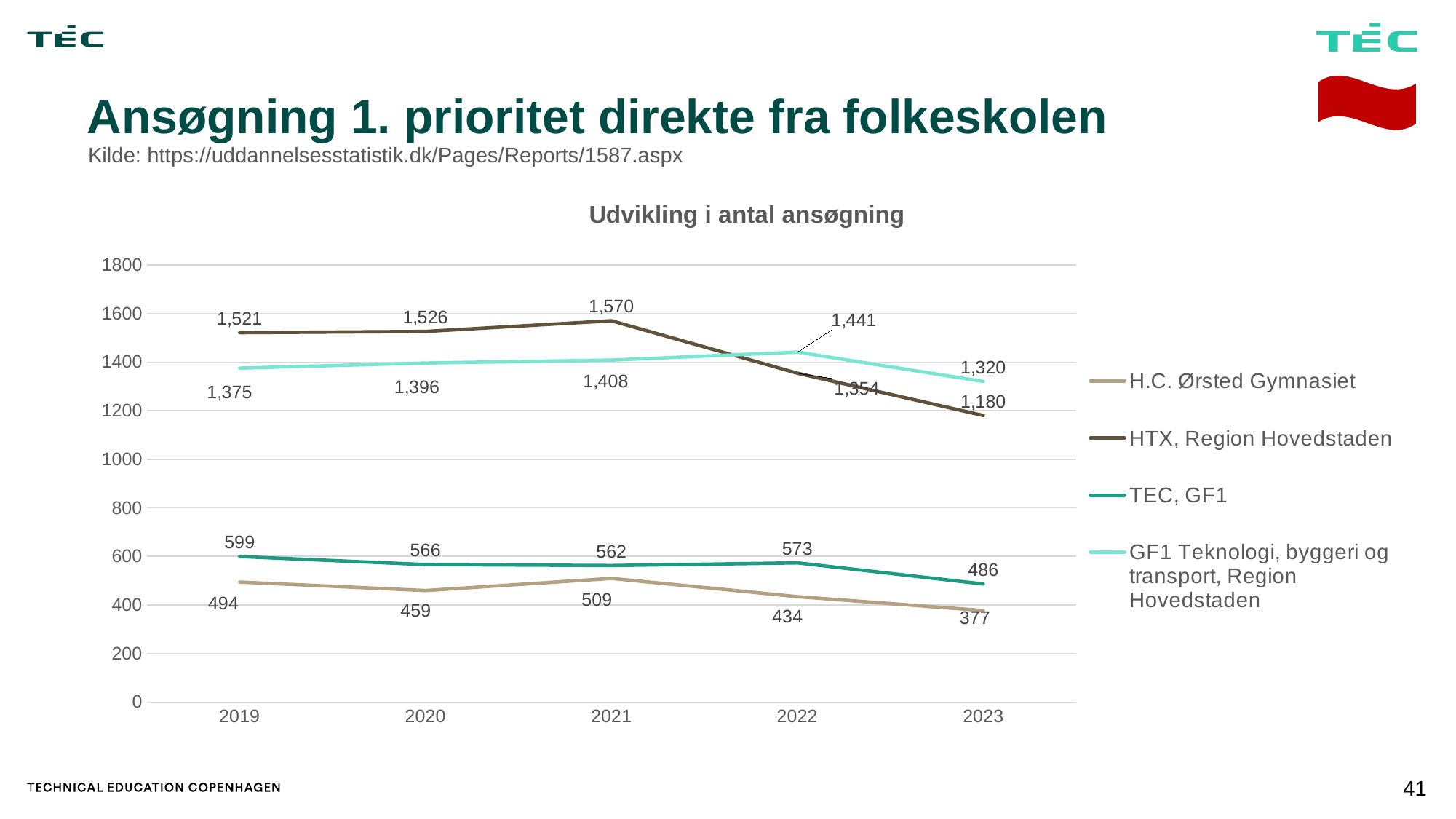
In which year is the value for H.C. Ørsted Gymnasiet lowest? 2023 What is the difference between the HTX, Region Hovedstaden values in 2021 and 2023? 390 How many series does the chart legend list? 4 In which year is the value for GF1 Teknologi, byggeri og transport, Region Hovedstaden highest? 2022 What is the value for HTX, Region Hovedstaden in 2021? 1,570 Does the value for TEC, GF1 rise or fall from 2022 to 2023? fall What is the title of the chart? Udvikling i antal ansøgning What kind of chart is shown on the slide? line chart What is the value for H.C. Ørsted Gymnasiet in 2020? 459 Which is larger in 2022: the value for HTX, Region Hovedstaden or the value for GF1 Teknologi, byggeri og transport, Region Hovedstaden? GF1 Teknologi, byggeri og transport, Region Hovedstaden How many years are shown on the x axis of the chart? 5 What is the value for TEC, GF1 in 2023? 486